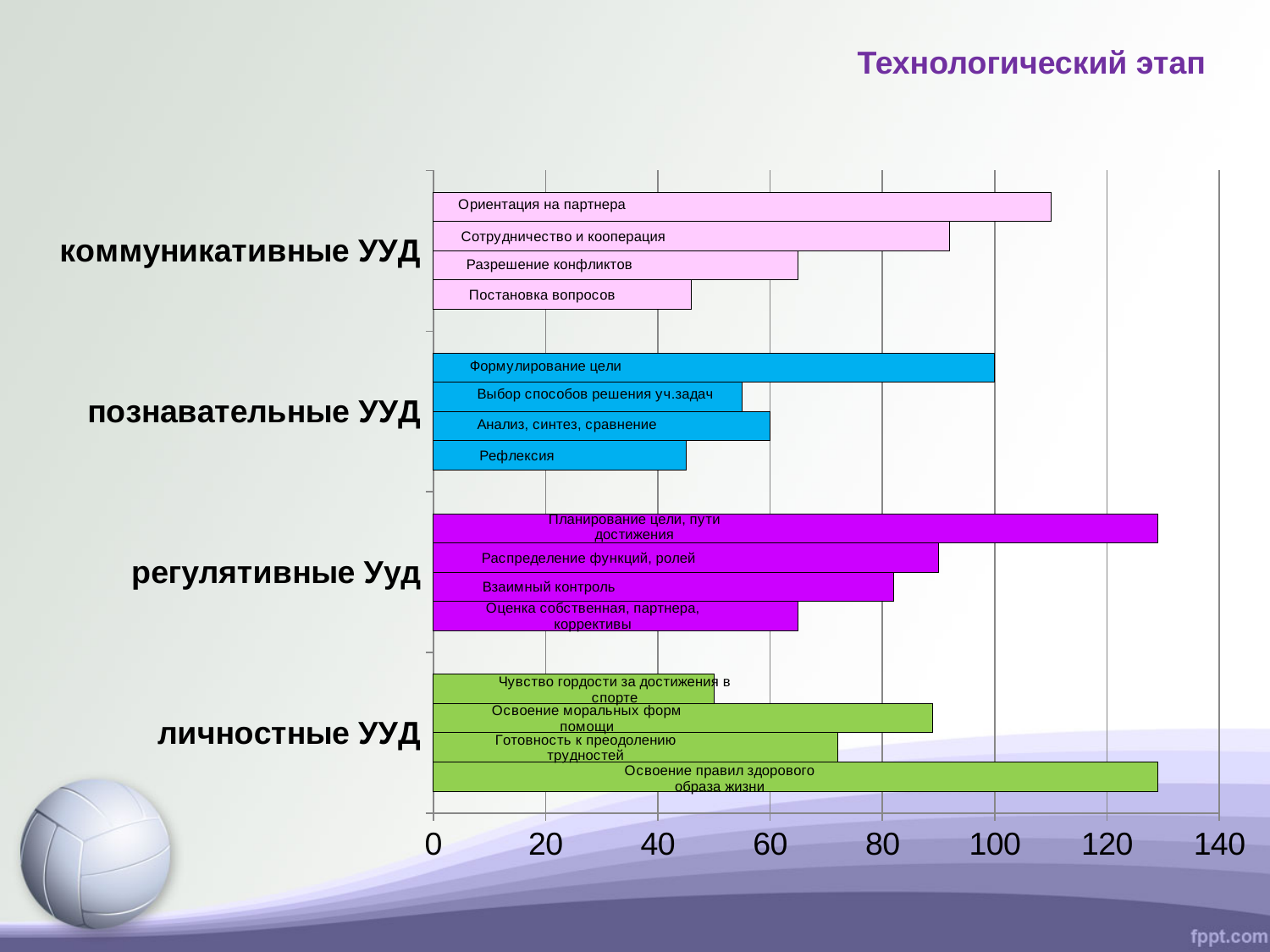
Which bar in the 'личностные УУД' group is the longest? Освоение правил здорового образа жизни What kind of chart is shown on the slide? bar chart Which is larger: the value for 'Взаимный контроль' or the value for 'Оценка собственная, партнера, коррективы'? Взаимный контроль What is the title shown at the top of the slide? Технологический этап Is the value for 'Ориентация на партнера' greater or less than 100? greater Is the value for 'Рефлексия' greater or less than 40? greater Is the value for 'Постановка вопросов' greater or less than 60? less How many bars are plotted in the chart in total? 16 Which bar in the 'коммуникативные УУД' group is the longest? Ориентация на партнера Which bar in the 'познавательные УУД' group is the shortest? Рефлексия How many category groups (УУД types) are shown on the chart's vertical axis? 4